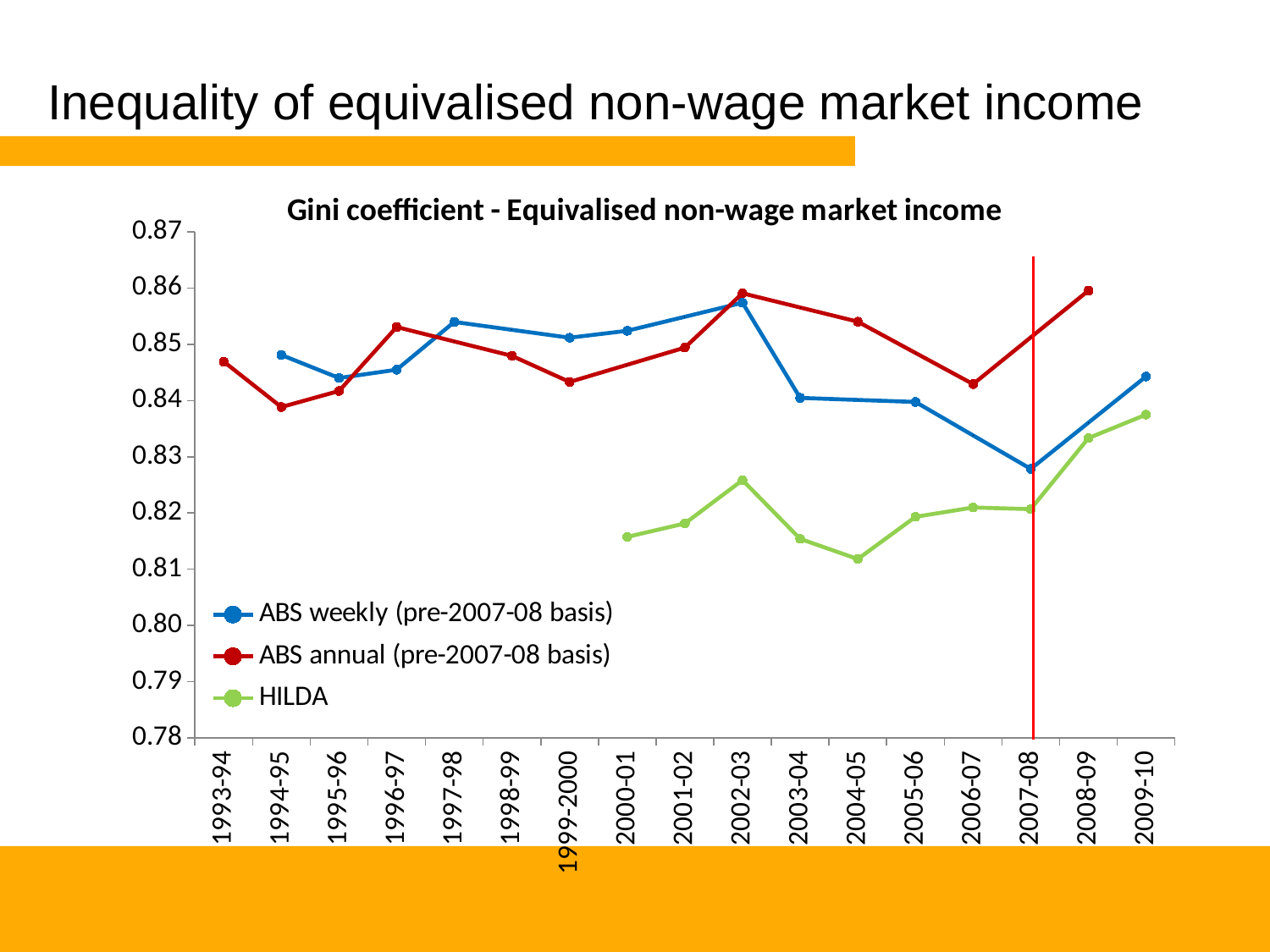
Is the ABS annual (pre-2007-08 basis) value for 2008-09 greater or less than 0.85? greater Is the ABS weekly (pre-2007-08 basis) value for 2007-08 greater or less than 0.83? less In which year is the HILDA series at its lowest? 2004-05 In 2003-04, which is higher: ABS annual (pre-2007-08 basis) or ABS weekly (pre-2007-08 basis)? ABS annual (pre-2007-08 basis) What is the title of the chart? Gini coefficient - Equivalised non-wage market income In which year is the ABS weekly (pre-2007-08 basis) series at its lowest? 2007-08 Is the HILDA value for 2004-05 greater or less than 0.82? less What kind of chart is shown on the slide? Line chart How many series does the legend list? 3 In which year is the HILDA series at its highest? 2009-10 Does the HILDA series rise or fall from 2007-08 to 2009-10? Rise How many financial years are shown on the x axis? 17